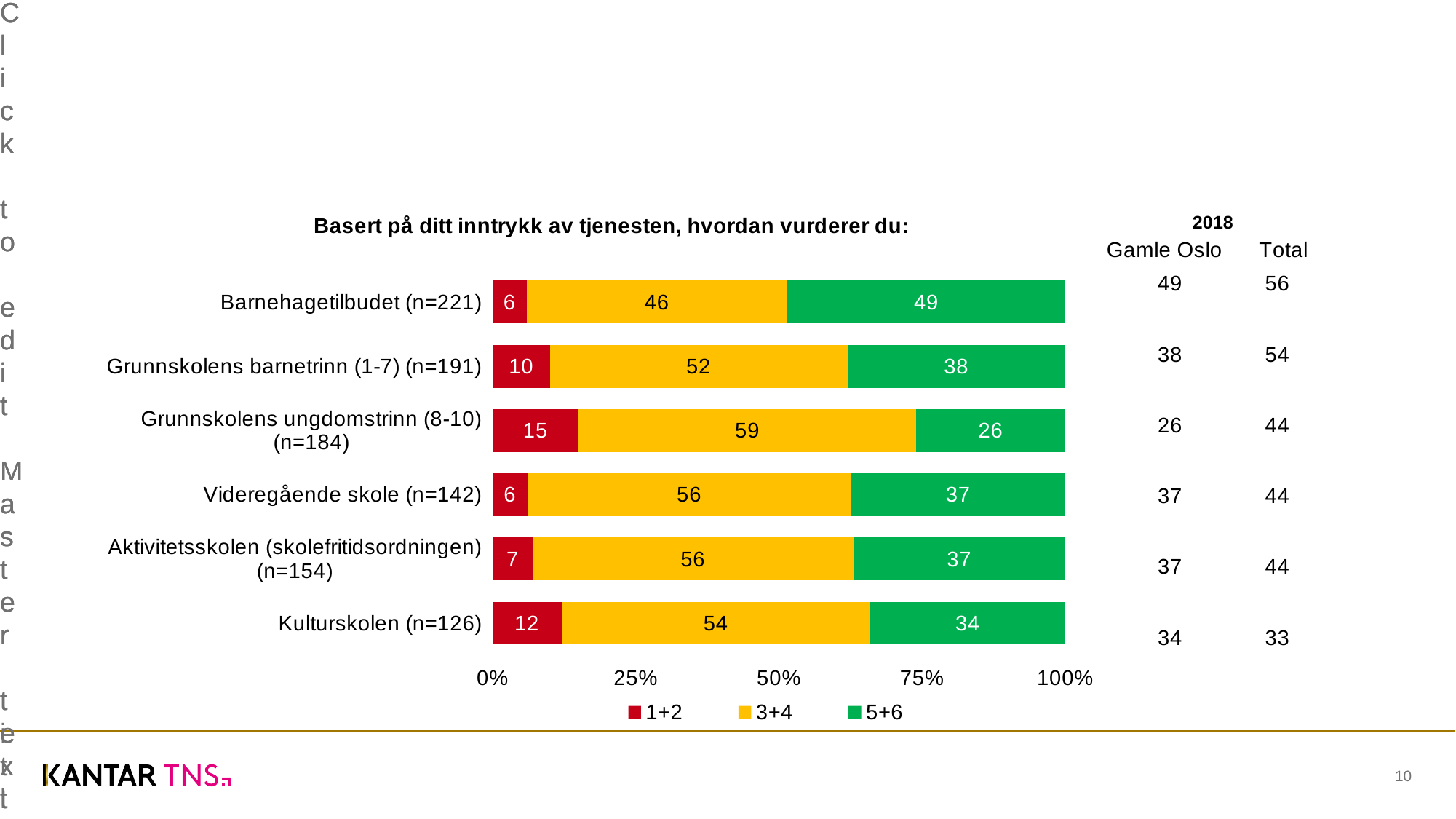
What is the difference between the 3+4 values for Grunnskolens ungdomstrinn (8-10) (n=184) and Barnehagetilbudet (n=221)? 13 What is the value of the 1+2 series for Grunnskolens ungdomstrinn (8-10) (n=184)? 15 Which category has the highest value in the 1+2 series? Grunnskolens ungdomstrinn (8-10) (n=184) How many categories are shown on the chart? 6 What is the value of the 3+4 series for Kulturskolen (n=126)? 54 Which category has the lowest value in the 5+6 series? Grunnskolens ungdomstrinn (8-10) (n=184) Which category has the highest value in the 5+6 series? Barnehagetilbudet (n=221) Which is larger: the 5+6 value for Grunnskolens barnetrinn (1-7) (n=191) or for Kulturskolen (n=126)? Grunnskolens barnetrinn (1-7) (n=191) What is the value of the 5+6 series for Barnehagetilbudet (n=221)? 49 What kind of chart is shown on the slide? Stacked bar chart What is the title of the chart? Basert på ditt inntrykk av tjenesten, hvordan vurderer du: How many series does the legend list? 3